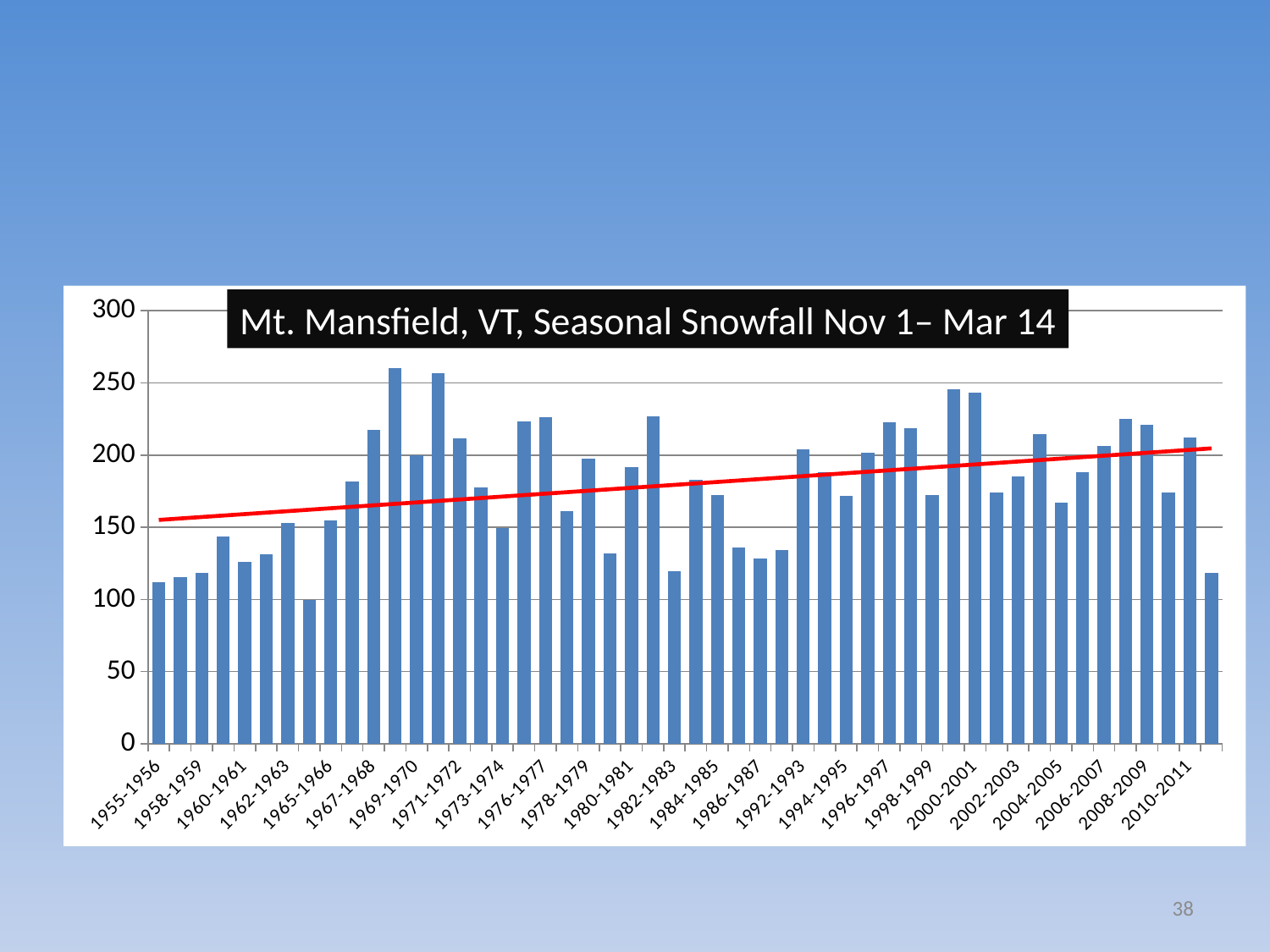
What kind of chart is shown on the slide? bar chart Is the value for 2004-2005 greater or less than 200? less Is the value for 2000-2001 greater or less than 200? greater Is the value for 1955-1956 greater or less than 150? less What is the title of the chart? Mt. Mansfield, VT, Seasonal Snowfall Nov 1– Mar 14 Which is larger, the value for 1955-1956 or the value for 1967-1968? 1967-1968 According to the red trend line, do seasonal snowfall values generally rise or fall from the 1950s to the 2010s? rise What colour is the trend line drawn across the bars? red